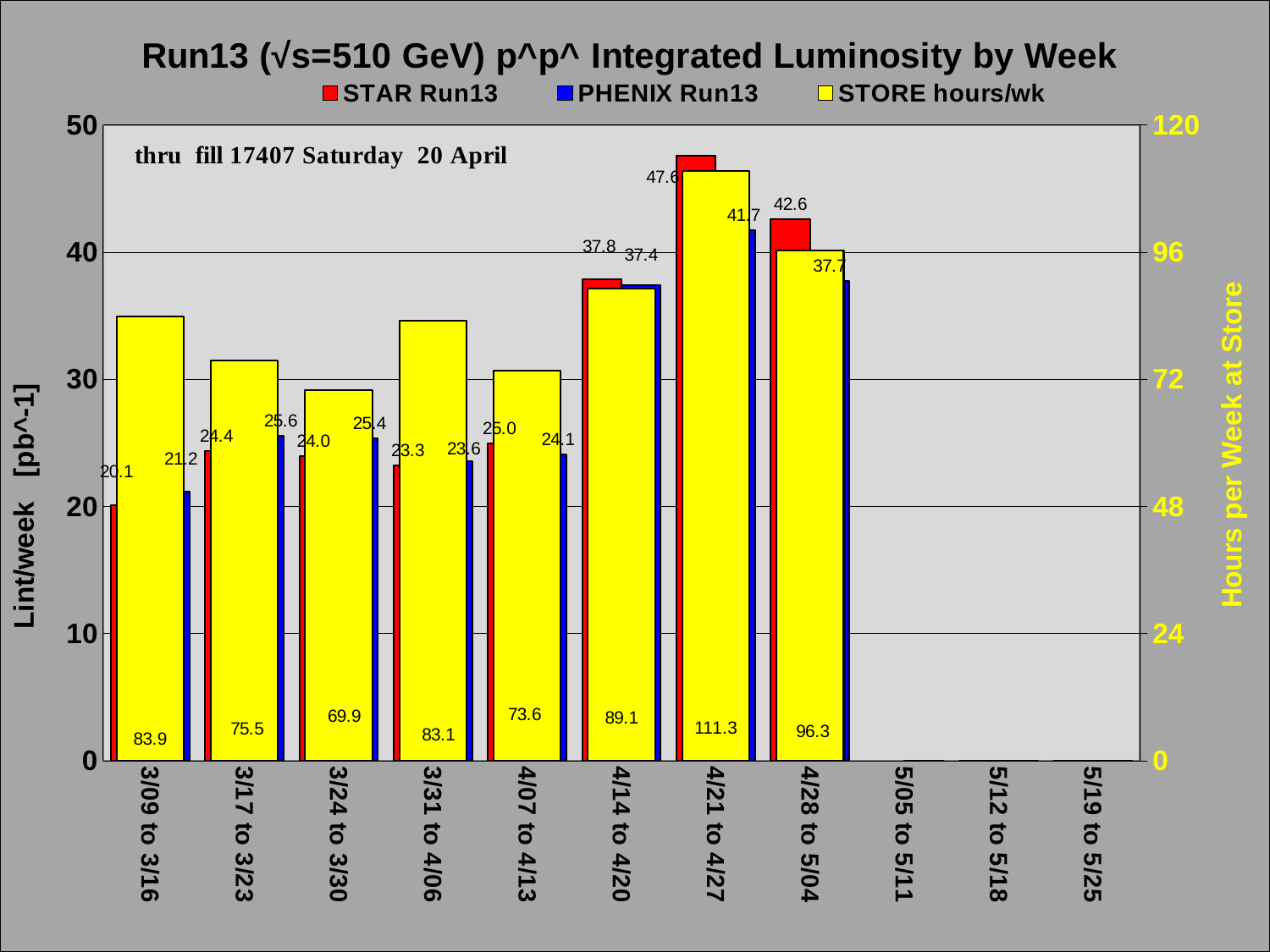
What is the difference between the STAR Run13 and PHENIX Run13 values for the week 4/21 to 4/27? 5.9 What is the STAR Run13 value for the week 4/21 to 4/27? 47.6 What is the STORE hours/wk value for the week 4/28 to 5/04? 96.3 What is the PHENIX Run13 value for the week 3/09 to 3/16? 21.2 Which week has the highest STORE hours/wk value? 4/21 to 4/27 How many series does the legend list? 3 How many week categories are shown on the x axis? 11 Which is larger for the week 3/17 to 3/23, the STAR Run13 value or the PHENIX Run13 value? PHENIX Run13 What is the difference between the STORE hours/wk values for the weeks 4/21 to 4/27 and 4/28 to 5/04? 15.0 Which week has the lowest STAR Run13 value? 3/09 to 3/16 What colour represents the STORE hours/wk series? Yellow What kind of chart is this? Bar chart